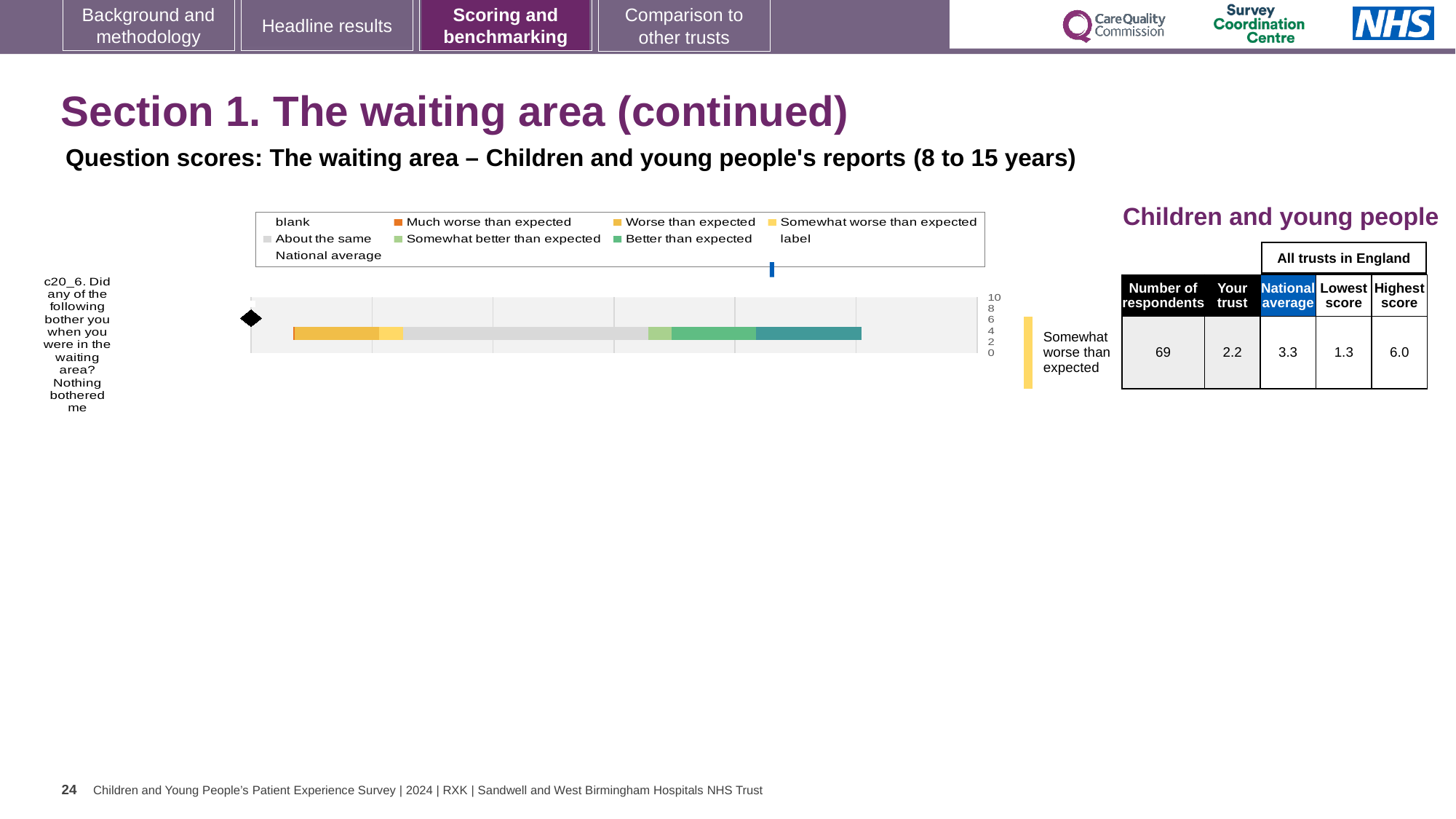
In the table, what is the 'Your trust' score for question c20_6? 2.2 What is the difference between the national average (3.3) and the 'Your trust' score (2.2) for question c20_6? 1.1 In the table, what is the number of respondents for question c20_6? 69 In the table, what is the lowest score among all trusts in England for question c20_6? 1.3 How many entries does the chart legend list? 9 Which is larger for question c20_6: the 'Your trust' score or the national average? National average How many survey questions are plotted in the chart? 1 What kind of chart is shown on the slide? Bar chart What rating label is shown to the right of the bar for question c20_6? Somewhat worse than expected Which question code is plotted in the chart? c20_6 In the table, what is the national average score for question c20_6? 3.3 In the table, what is the highest score among all trusts in England for question c20_6? 6.0